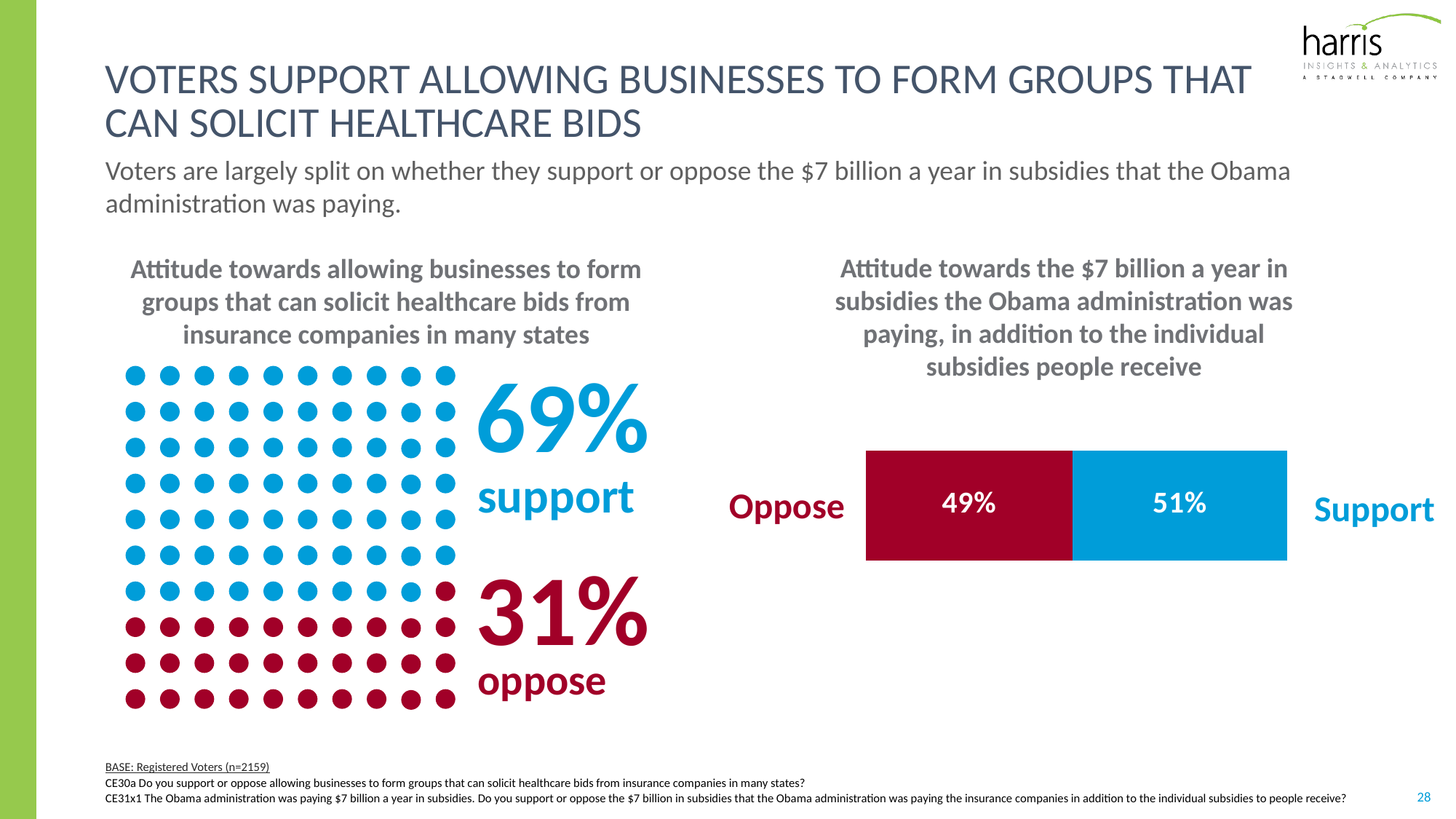
In the left chart on allowing businesses to form groups to solicit healthcare bids, what colour are the dots representing support? blue In the right chart on attitude towards the $7 billion a year in subsidies, what percentage of voters support the subsidies? 51% In the left chart on attitude towards allowing businesses to form groups that can solicit healthcare bids, what percentage of voters support it? 69% How many response categories are shown in the right chart on the $7 billion a year in subsidies? 2 In the right chart on the $7 billion a year in subsidies, what do the oppose and support percentages add up to? 100% In the left chart on allowing businesses to form groups to solicit healthcare bids, what is the difference in percentage points between support and oppose? 38 What kind of chart is the right chart on attitude towards the $7 billion a year in subsidies? stacked bar chart In the left chart on allowing businesses to form groups to solicit healthcare bids, which is larger: support or oppose? support In the right chart on the $7 billion a year in subsidies, what is the difference in percentage points between support and oppose? 2 In the right chart on attitude towards the $7 billion a year in subsidies, what percentage of voters oppose the subsidies? 49% In the left chart on attitude towards allowing businesses to form groups that can solicit healthcare bids, what percentage of voters oppose it? 31% In the right chart on the $7 billion a year in subsidies, what colour is the Oppose segment? dark red